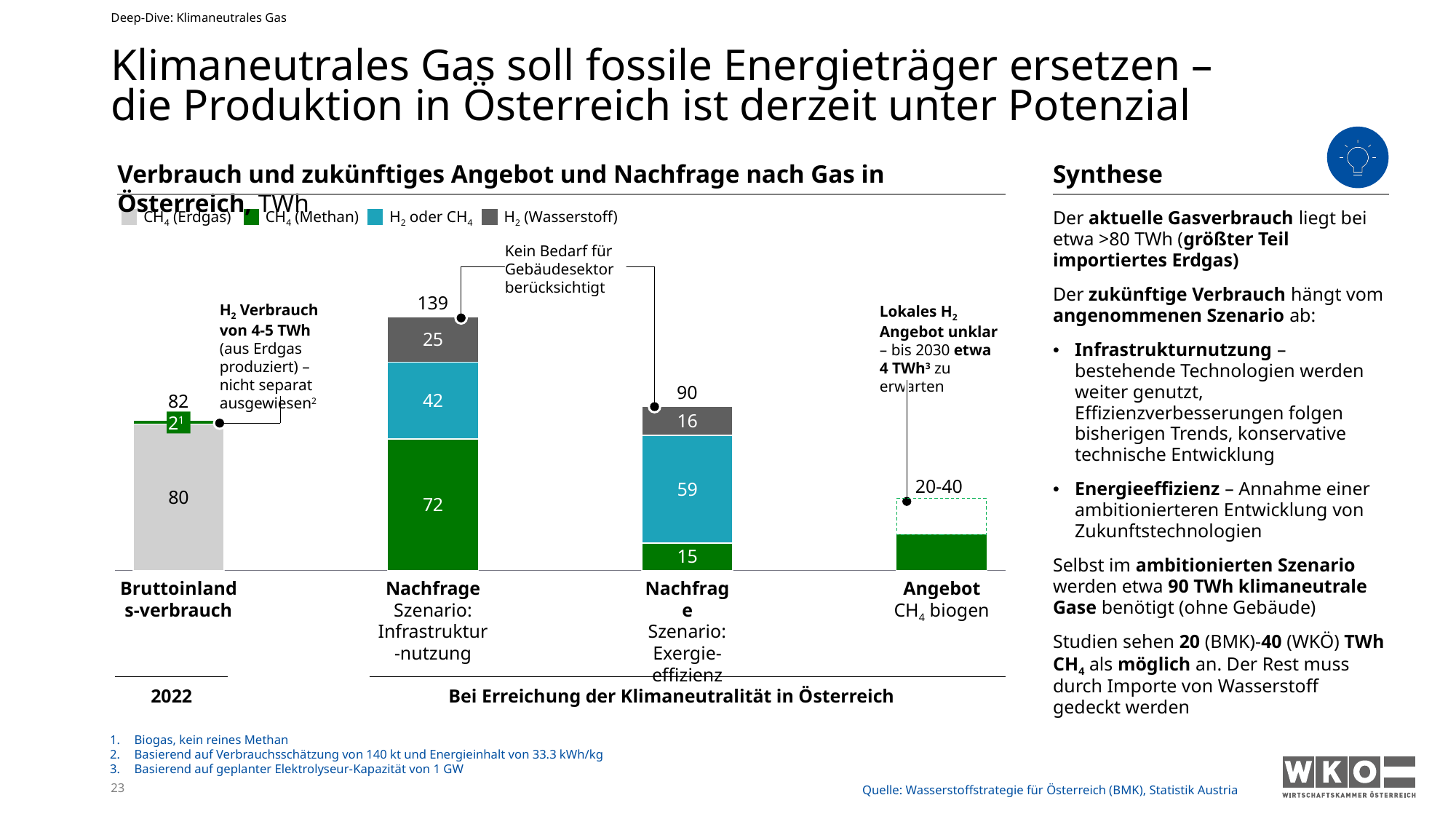
What is the CH4 (Methan) value in the 'Nachfrage Szenario: Infrastrukturnutzung' bar? 72 Which is larger: the H2 oder CH4 value in the Infrastrukturnutzung scenario or in the Exergieeffizienz scenario? Exergieeffizienz scenario (59) What is the total value shown for the 'Nachfrage Szenario: Exergieeffizienz' bar? 90 What is the H2 (Wasserstoff) value in the 'Nachfrage Szenario: Exergieeffizienz' bar? 16 What type of chart is shown on the slide? Stacked bar chart Which bar has the highest total value? Nachfrage Szenario: Infrastrukturnutzung How many series does the legend list? 4 What is the CH4 (Erdgas) value in the 'Bruttoinlandsverbrauch' bar? 80 What is the total value shown for the 'Nachfrage Szenario: Infrastrukturnutzung' bar? 139 What value range is labelled on the 'Angebot CH4 biogen' bar? 20-40 What is the H2 oder CH4 value in the 'Nachfrage Szenario: Exergieeffizienz' bar? 59 What is the difference between the totals of the 'Nachfrage Szenario: Infrastrukturnutzung' bar (139) and the 'Nachfrage Szenario: Exergieeffizienz' bar (90)? 49